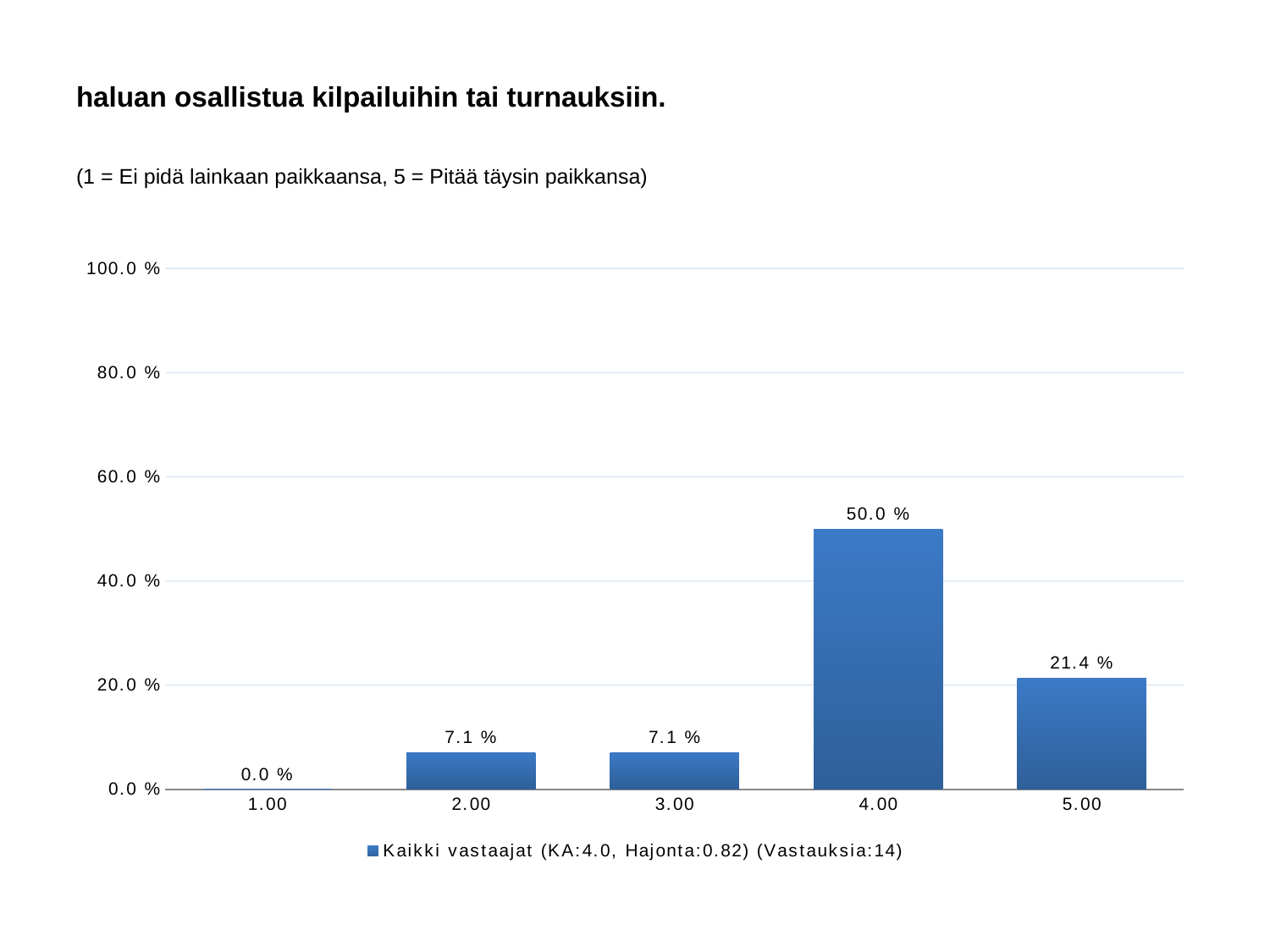
How many responses (Vastauksia) does the legend report? 14 How many categories are shown on the x axis? 5 What is the difference between the values for 4.00 and 5.00? 28.6 % Which category has the highest value? 4.00 What is the value for category 5.00? 21.4 % Which is larger, the value for 3.00 or the value for 5.00? 5.00 What is the value for category 1.00? 0.0 % Is the value for 4.00 greater or less than 40.0 %? greater What kind of chart is shown? bar chart How many series does the legend list? 1 What is the value for category 4.00? 50.0 % Which category has the lowest value? 1.00